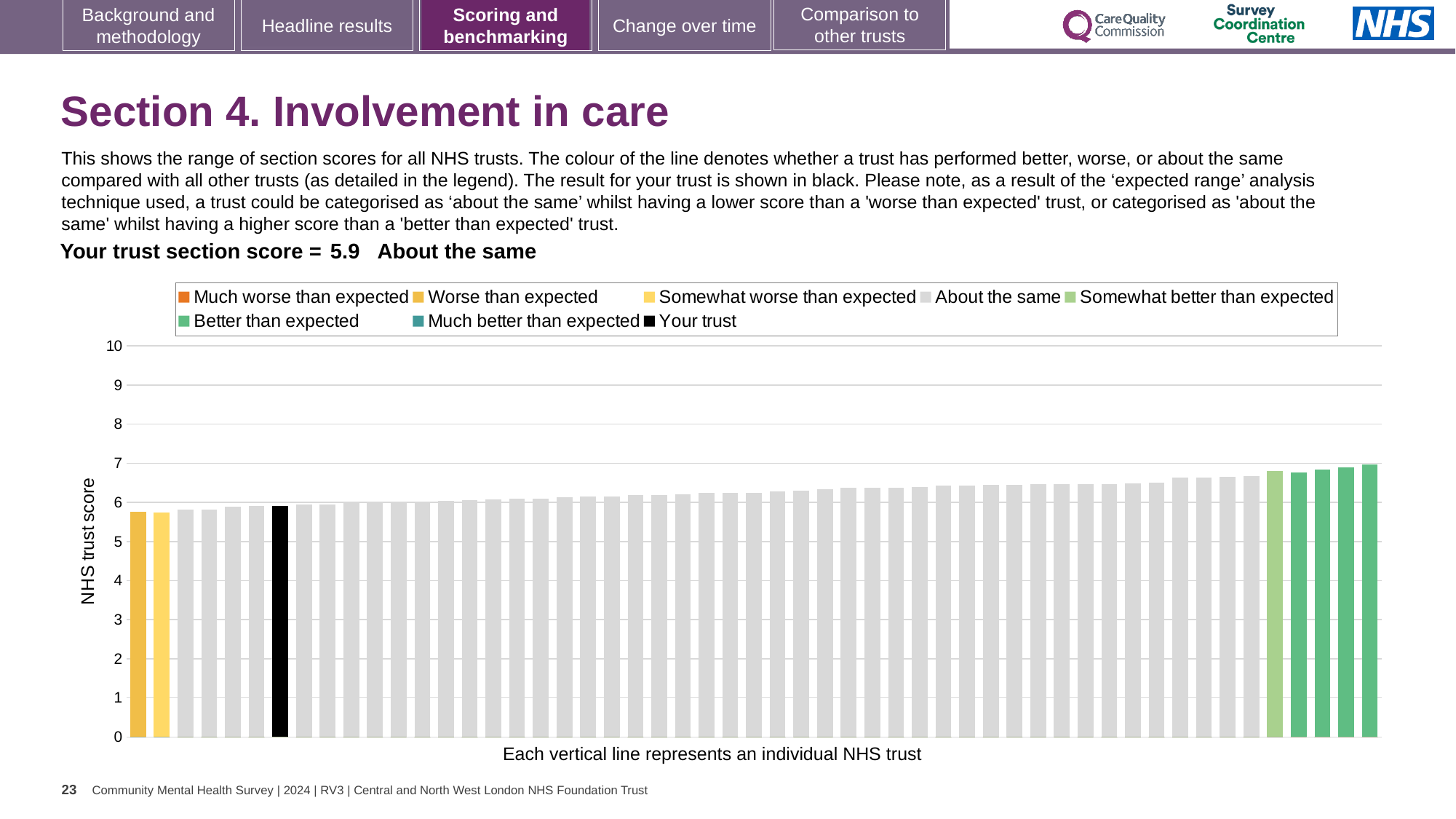
Do the bar values rise or fall from left to right along the x axis? rise What is the label on the vertical axis of the chart? NHS trust score Is the value of the highest bar greater or less than 8? less What kind of chart is shown on the slide? bar chart How many yellow bars (worse or somewhat worse than expected) are shown at the left of the chart? 2 Is the value of the highest bar greater or less than 6? greater How is your trust's section score categorised compared with other trusts? About the same How many entries does the chart legend list? 8 Is the value for your trust greater or less than 5? greater What is the section score for your trust shown on the slide? 5.9 How many bars are coloured orange (Much worse than expected)? 0